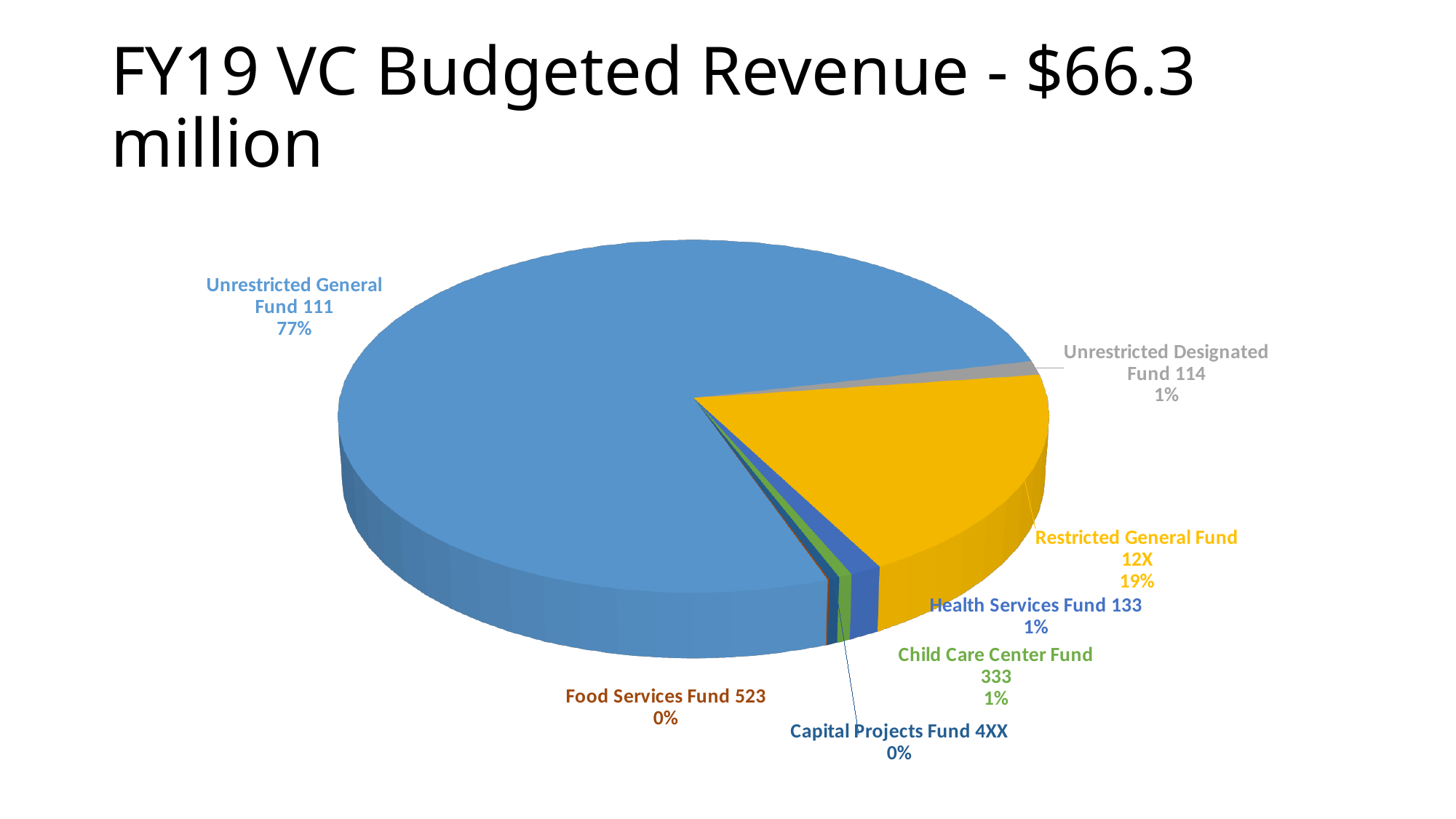
Which is larger, the share for Unrestricted General Fund 111 or the share for Restricted General Fund 12X? Unrestricted General Fund 111 What share of the pie does Restricted General Fund 12X represent? 19% How many slices does the pie chart have? 7 What percentage is shown for Child Care Center Fund 333? 1% What percentage is shown for Capital Projects Fund 4XX? 0% What share of the pie does Unrestricted General Fund 111 represent? 77% What percentage is shown for Health Services Fund 133? 1% Which fund has the largest share of the pie? Unrestricted General Fund 111 What percentage is shown for Food Services Fund 523? 0% What kind of chart is shown on the slide? Pie chart What percentage is shown for Unrestricted Designated Fund 114? 1% What is the difference in percentage points between Unrestricted General Fund 111 and Restricted General Fund 12X? 58